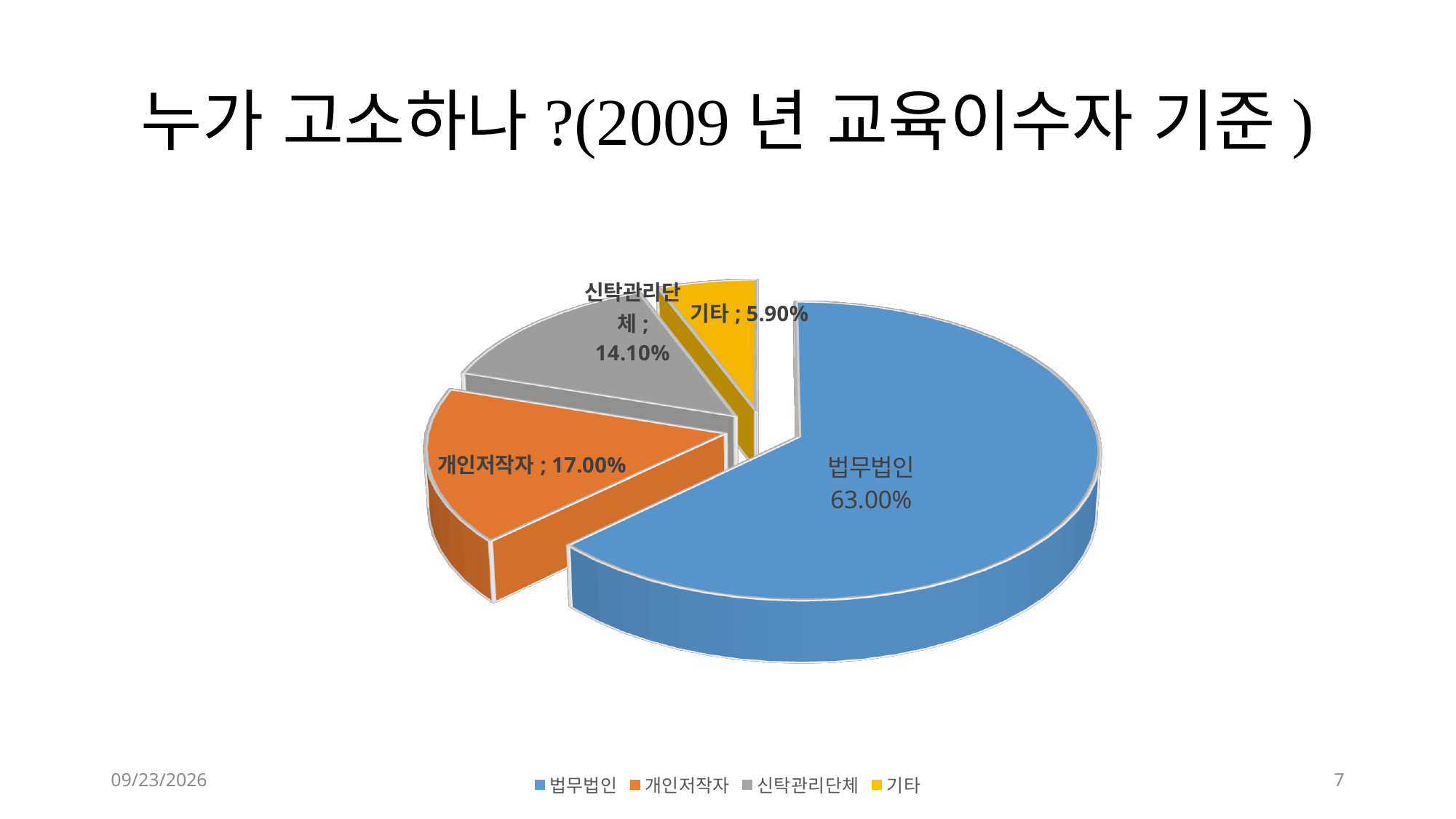
Which category has the largest slice of the pie? 법무법인 What kind of chart is shown on the slide? pie chart What is the difference between the shares of 신탁관리단체 and 기타? 8.20% Which is larger, the share of 개인저작자 or the share of 신탁관리단체? 개인저작자 What share of the pie does 기타 have? 5.90% Which category has the smallest slice of the pie? 기타 What is the difference between the shares of 법무법인 and 개인저작자? 46.00% What share of the pie does 법무법인 have? 63.00% How many slices does the pie chart have? 4 What share of the pie does 개인저작자 have? 17.00% What colour is the 법무법인 slice? blue What share of the pie does 신탁관리단체 have? 14.10%